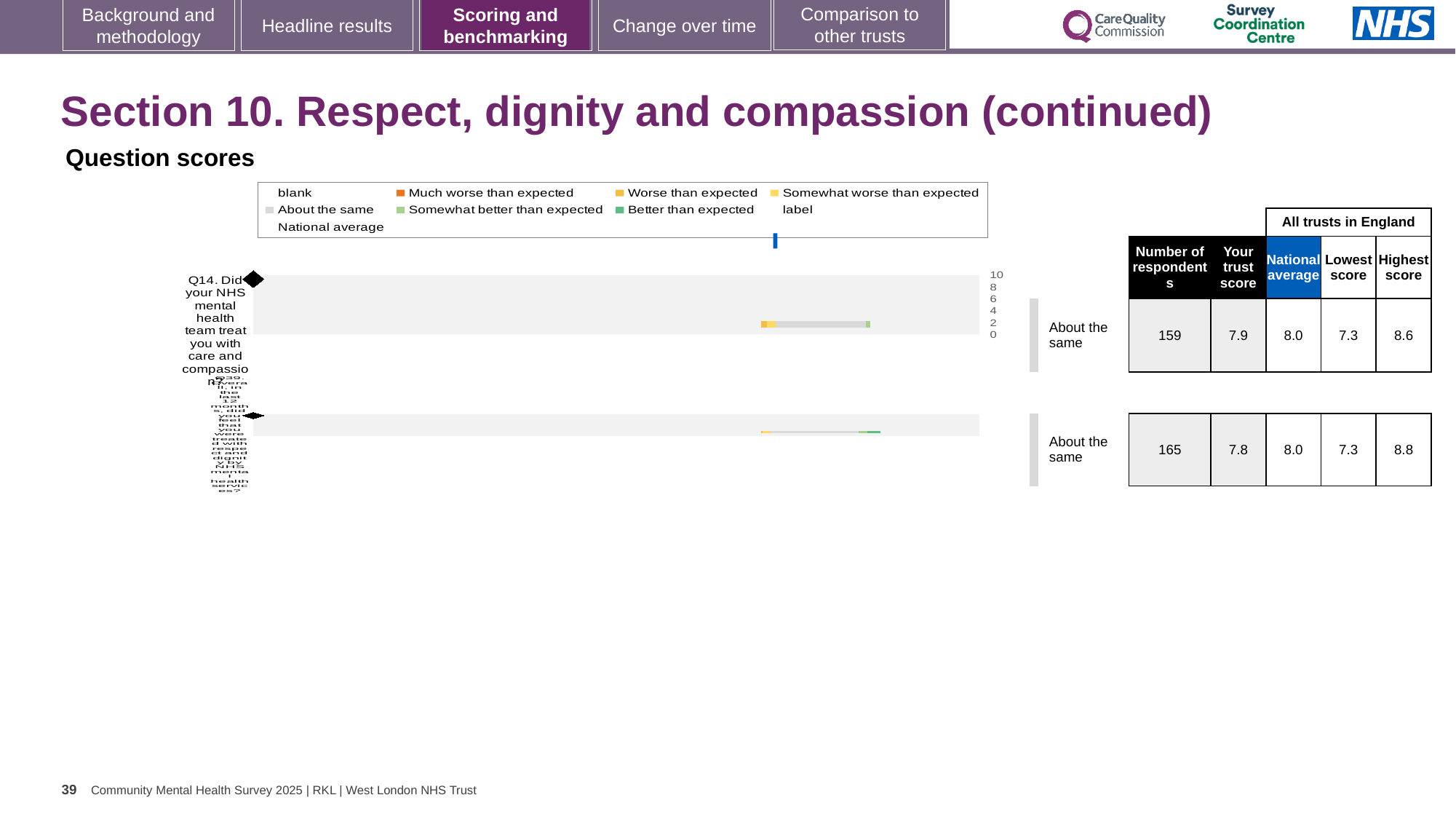
What kind of chart is used to show the question scores on this slide? bar chart How many respondents answered Q14? 159 How many questions are plotted in the question scores chart? 2 What is the trust score for Q39 (treated with respect and dignity)? 7.8 What is the highest score among all trusts in England for Q39? 8.8 What is the lowest score among all trusts in England for Q14? 7.3 Which benchmark category is shown for Q14? About the same What is the national average score for Q14? 8.0 What is the trust score for Q14 (treated with care and compassion)? 7.9 Which question had more respondents, Q14 or Q39? Q39 How many respondents answered Q39? 165 What is the difference between the highest and lowest trust scores for Q39? 1.5